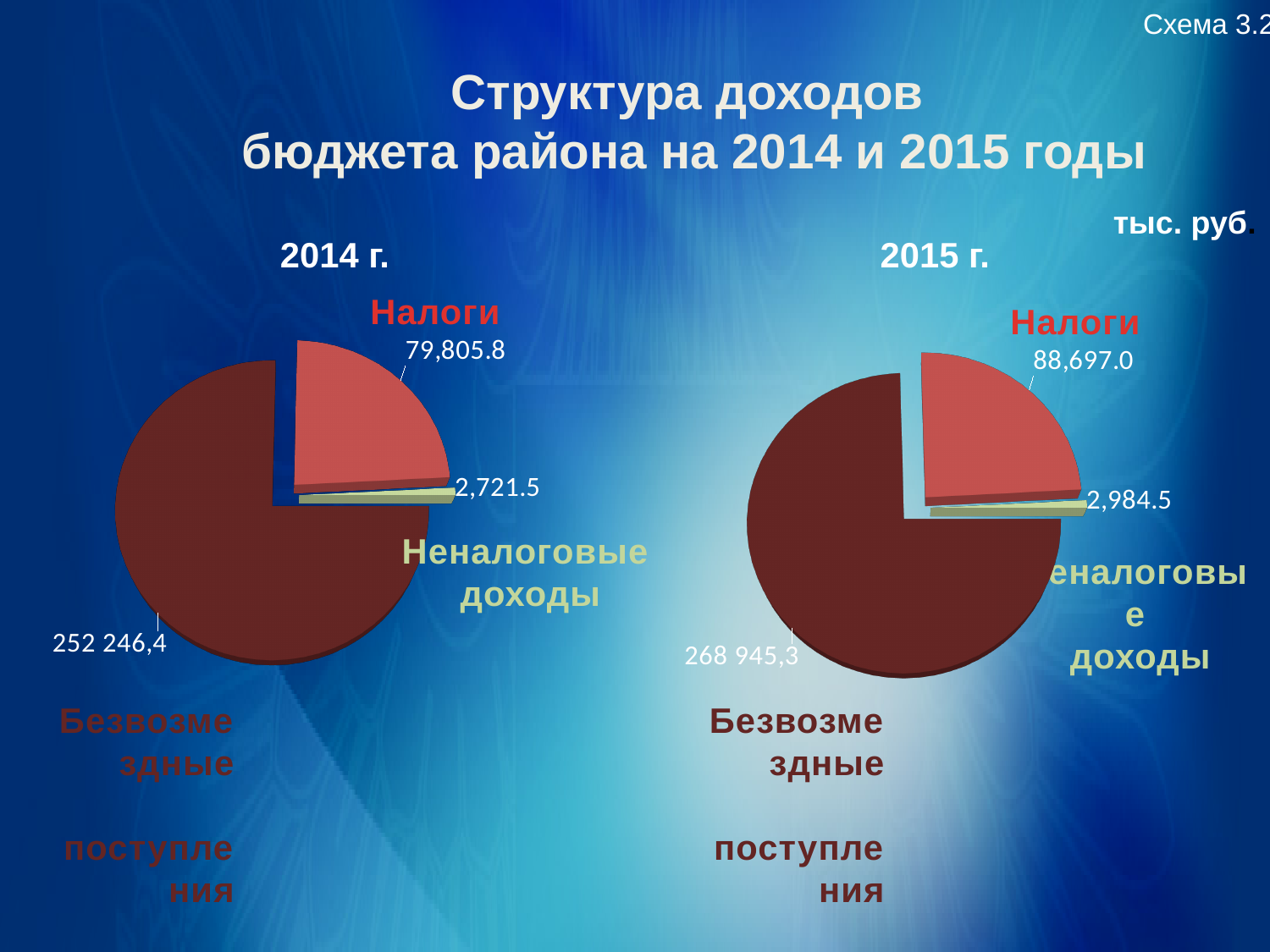
In the 2015 г. chart, what is the value for Безвозмездные поступления? 268 945,3 Which is larger: Налоги in the 2014 г. chart or Налоги in the 2015 г. chart? 2015 г. In the 2015 г. chart, what is the difference between Налоги and Неналоговые доходы? 85,712.5 In the 2014 г. chart, what is the value for Неналоговые доходы? 2,721.5 How many slices does the 2015 г. pie chart have? 3 In the 2014 г. chart, what is the value for Налоги? 79,805.8 In the 2014 г. chart, what is the value for Безвозмездные поступления? 252 246,4 In the 2014 г. chart, which category has the smallest slice? Неналоговые доходы In the 2015 г. chart, what is the value for Неналоговые доходы? 2,984.5 In the 2015 г. chart, what is the value for Налоги? 88,697.0 What kind of chart is used for the 2014 г. data? pie chart In the 2015 г. chart, which category has the largest slice? Безвозмездные поступления